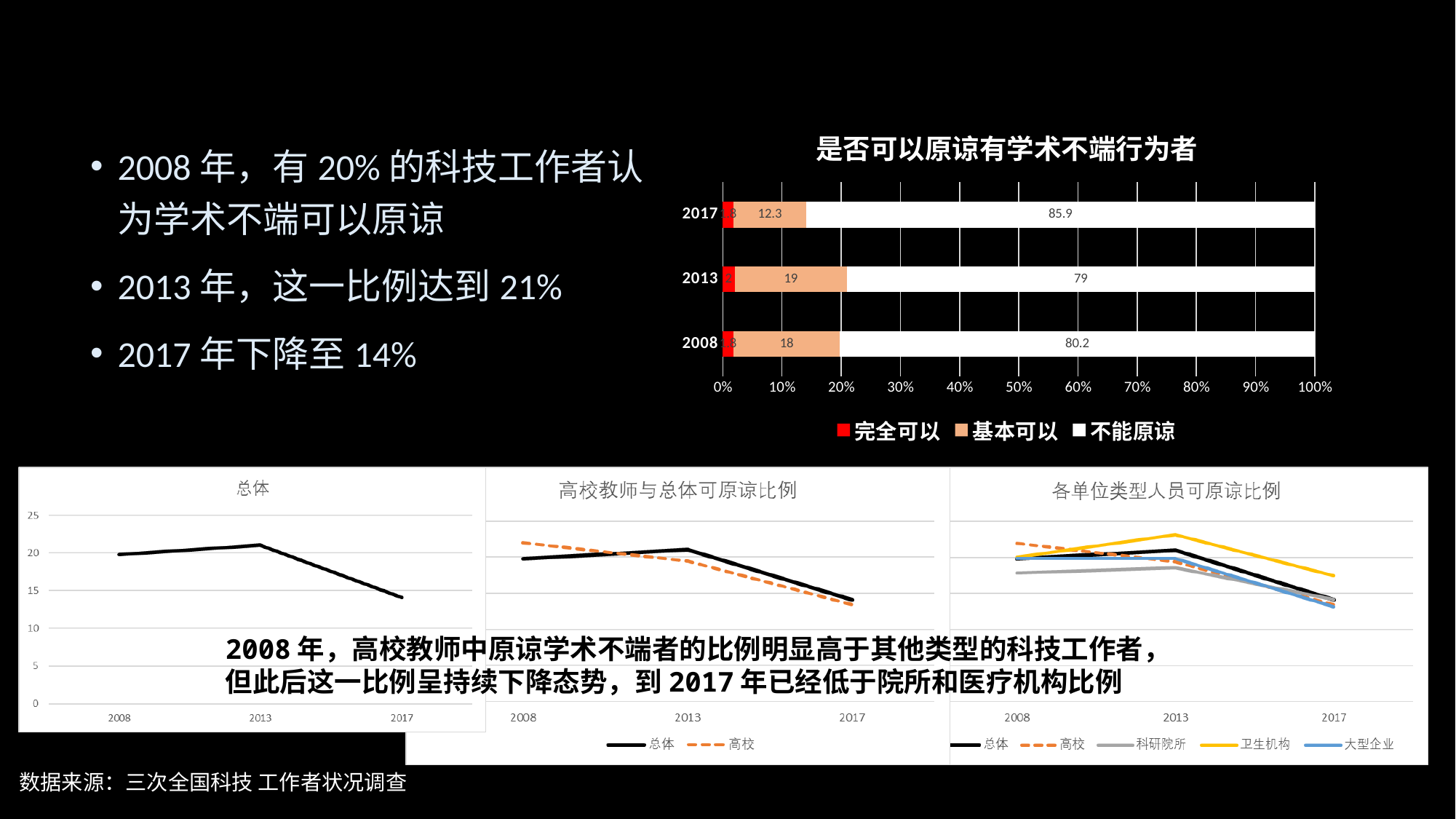
In the chart titled 是否可以原谅有学术不端行为者, which year has the highest 不能原谅 value? 2017 In the chart titled 是否可以原谅有学术不端行为者, what is the difference between the 不能原谅 values for 2017 and 2013? 6.9 What kind of chart is the one titled 是否可以原谅有学术不端行为者? Stacked bar chart In the chart titled 是否可以原谅有学术不端行为者, is the 基本可以 value larger for 2008 or for 2017? 2008 In the chart titled 是否可以原谅有学术不端行为者, which year has the lowest 基本可以 value? 2017 How many series does the legend of the chart titled 是否可以原谅有学术不端行为者 list? 3 In the line chart titled 总体, does the value rise or fall from 2013 to 2017? fall In the line chart titled 总体, is the value for 2017 greater or less than 15? less In the chart titled 是否可以原谅有学术不端行为者, what is the value of the 不能原谅 segment for 2017? 85.9 How many series does the legend of the chart titled 各单位类型人员可原谅比例 list? 5 In the chart titled 是否可以原谅有学术不端行为者, what is the value of the 基本可以 segment for 2013? 19 In the chart titled 是否可以原谅有学术不端行为者, what is the value of the 不能原谅 segment for 2008? 80.2